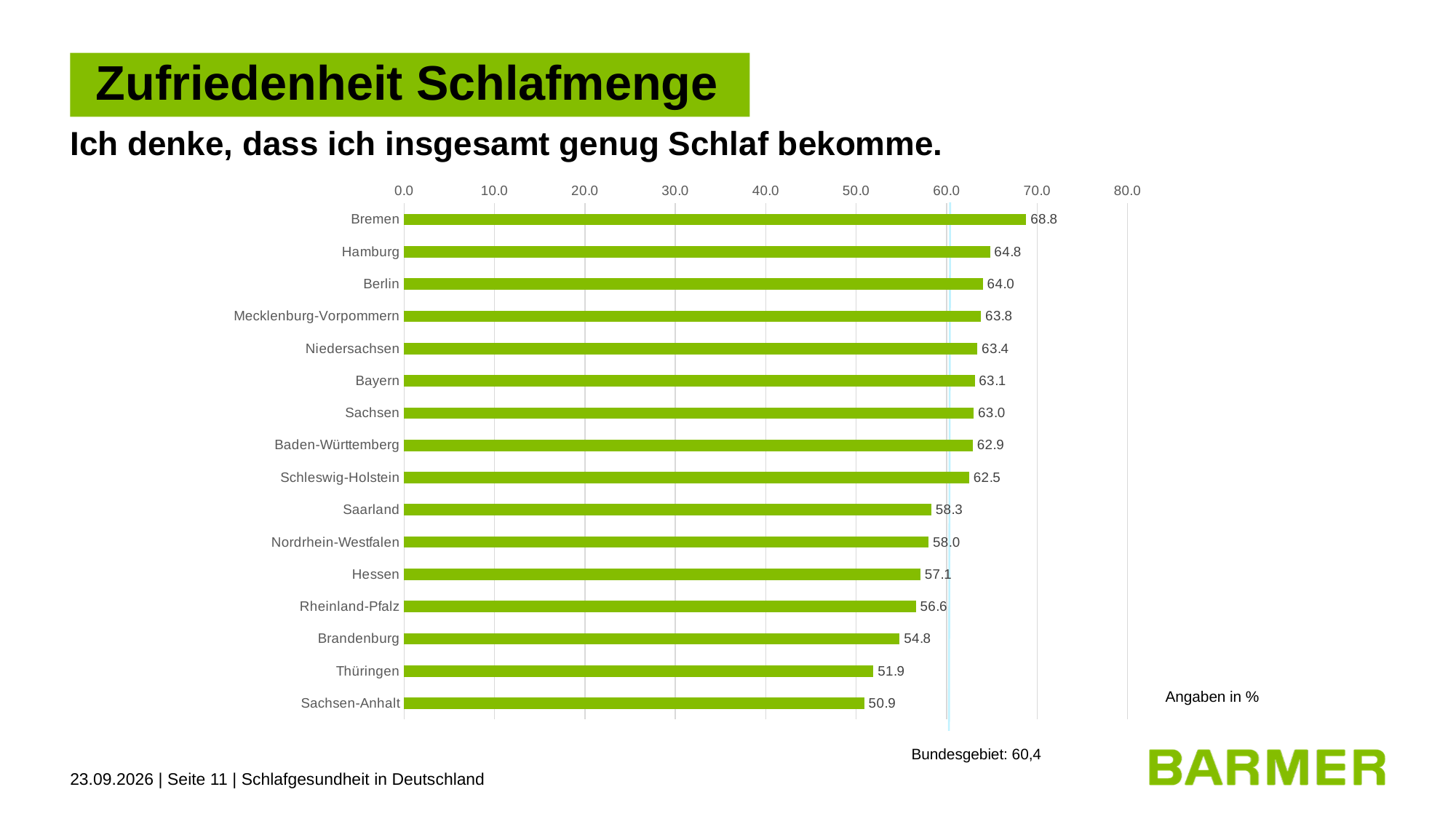
What is the value for Sachsen-Anhalt? 50.9 Which federal state has the highest value? Bremen What kind of chart is shown on the slide? bar chart Which has a larger value, Saarland or Brandenburg? Saarland What is the value for Bremen? 68.8 What value is given for Bundesgebiet below the chart? 60,4 Is the value for Thüringen greater or less than 60.0? less How many federal states are shown in the chart? 16 Which federal state has the lowest value? Sachsen-Anhalt What is the value for Hessen? 57.1 What is the difference between the values for Bremen and Sachsen-Anhalt? 17.9 What is the difference between the values for Hamburg and Berlin? 0.8